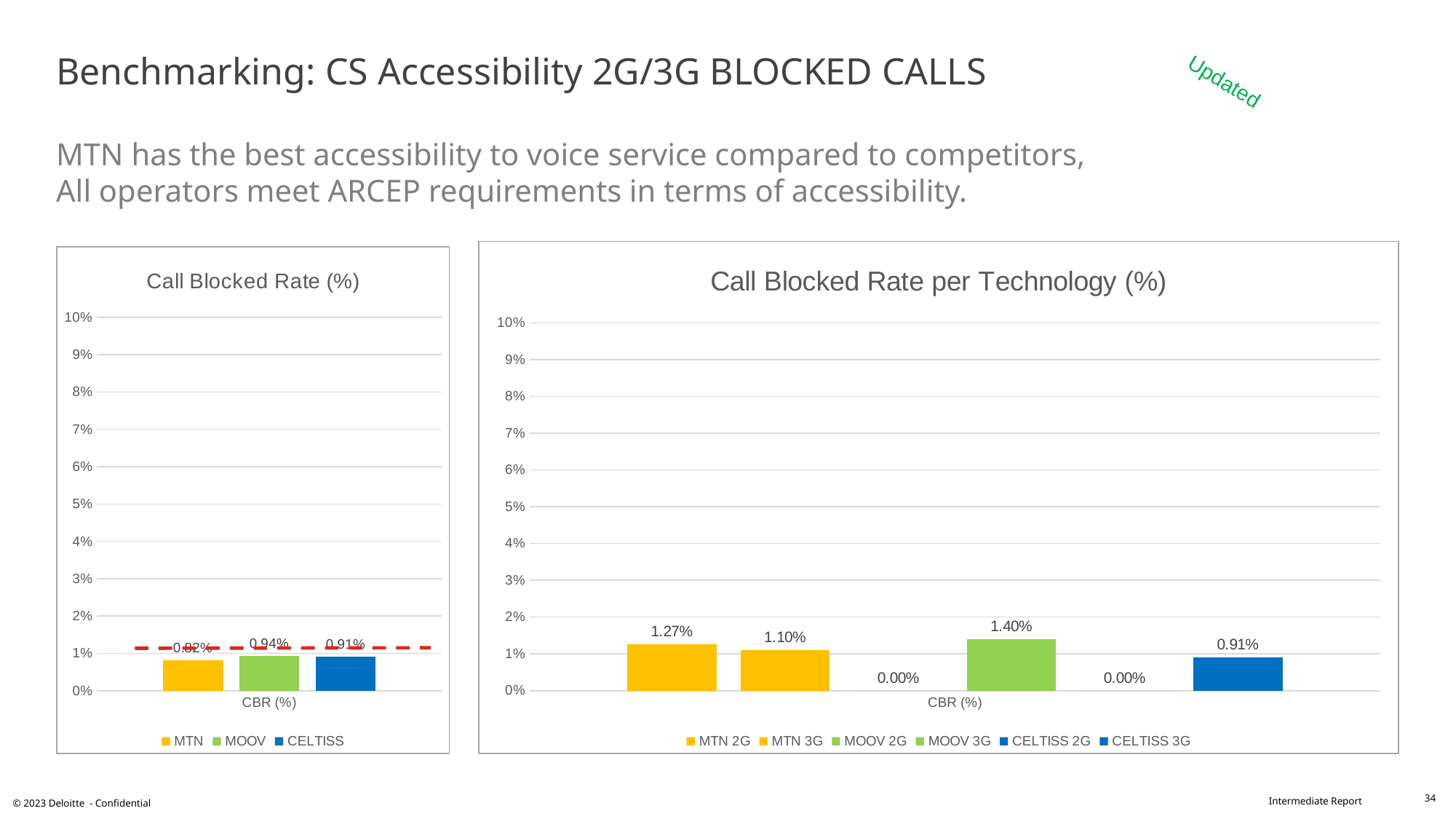
In the 'Call Blocked Rate (%)' chart on the left, what is the value for CELTISS? 0.91% In the 'Call Blocked Rate (%)' chart on the left, what is the value for MOOV? 0.94% How many series does the legend of the 'Call Blocked Rate (%)' chart on the left list? 3 In the 'Call Blocked Rate per Technology (%)' chart, what is the difference between MTN 2G and MTN 3G? 0.17% What kind of chart is the 'Call Blocked Rate per Technology (%)' chart? Bar chart In the 'Call Blocked Rate per Technology (%)' chart, is the value for MTN 2G greater or less than 1%? greater In the 'Call Blocked Rate per Technology (%)' chart, which series has the highest value? MOOV 3G In the 'Call Blocked Rate per Technology (%)' chart, what is the value for CELTISS 3G? 0.91% In the 'Call Blocked Rate per Technology (%)' chart, which is larger, MTN 3G or CELTISS 3G? MTN 3G How many series does the legend of the 'Call Blocked Rate per Technology (%)' chart list? 6 In the 'Call Blocked Rate per Technology (%)' chart, what is the value for MTN 2G? 1.27% In the 'Call Blocked Rate per Technology (%)' chart, what is the value for MOOV 3G? 1.40%